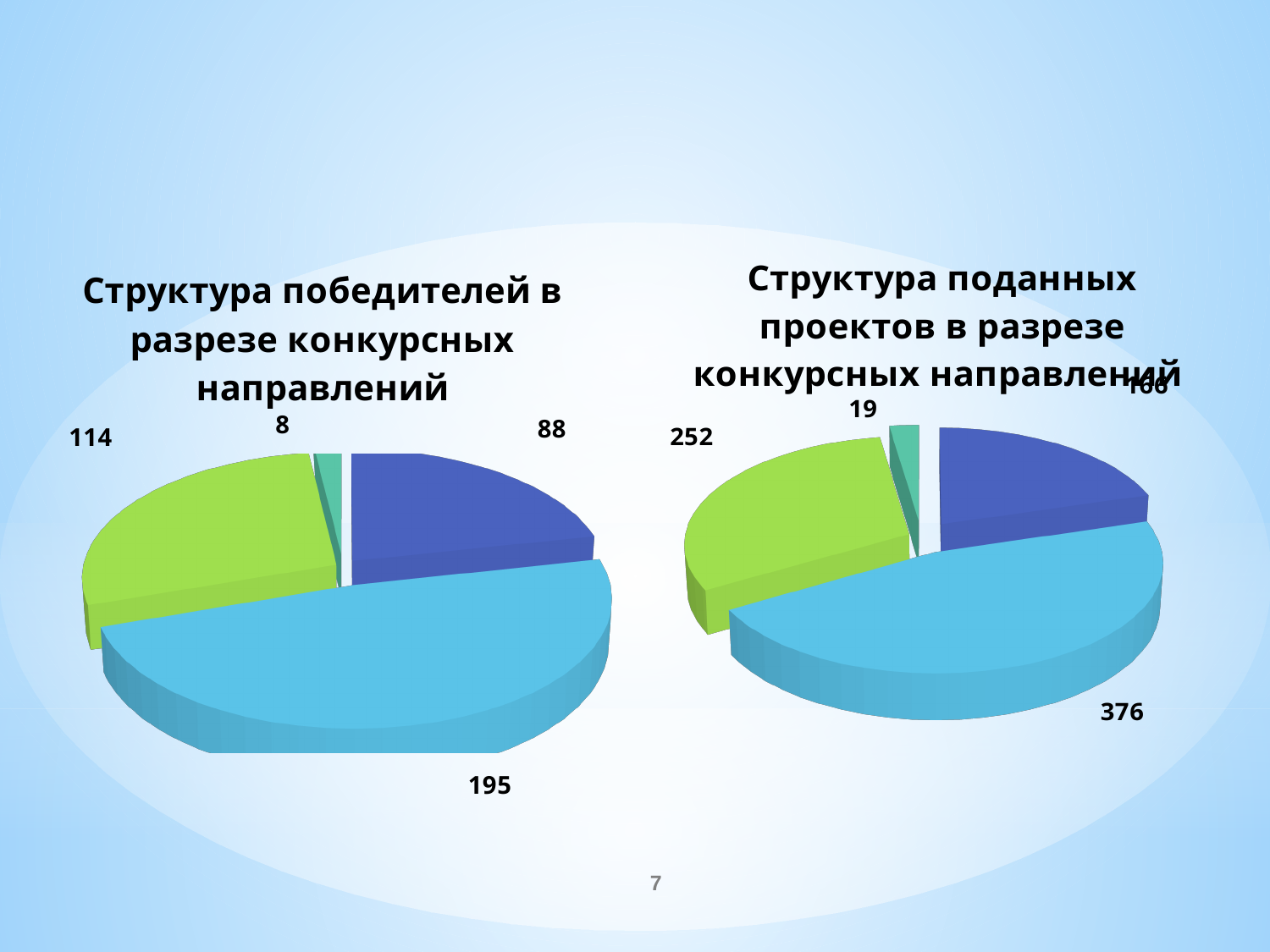
In the right chart, 'Структура поданных проектов в разрезе конкурсных направлений', what is the value of the largest slice? 376 In the left chart, 'Структура победителей в разрезе конкурсных направлений', what is the value of the largest slice? 195 In the right chart, 'Структура поданных проектов в разрезе конкурсных направлений', what is the value of the smallest slice? 19 In the left chart, 'Структура победителей в разрезе конкурсных направлений', what is the value of the green slice? 114 In the right chart, 'Структура поданных проектов в разрезе конкурсных направлений', which slice is larger: the light blue slice (376) or the green slice (252)? The light blue slice (376) In the left chart, 'Структура победителей в разрезе конкурсных направлений', what is the value of the smallest slice? 8 In the left chart, 'Структура победителей в разрезе конкурсных направлений', what is the difference between the light blue slice (195) and the green slice (114)? 81 What kind of chart is the left chart, 'Структура победителей в разрезе конкурсных направлений'? Pie chart What kind of chart is the right chart, 'Структура поданных проектов в разрезе конкурсных направлений'? Pie chart In the left chart, 'Структура победителей в разрезе конкурсных направлений', what is the total of all four slices (88, 195, 114 and 8)? 405 In the left chart, 'Структура победителей в разрезе конкурсных направлений', how many slices does the pie have? 4 In the right chart, 'Структура поданных проектов в разрезе конкурсных направлений', how many slices does the pie have? 4